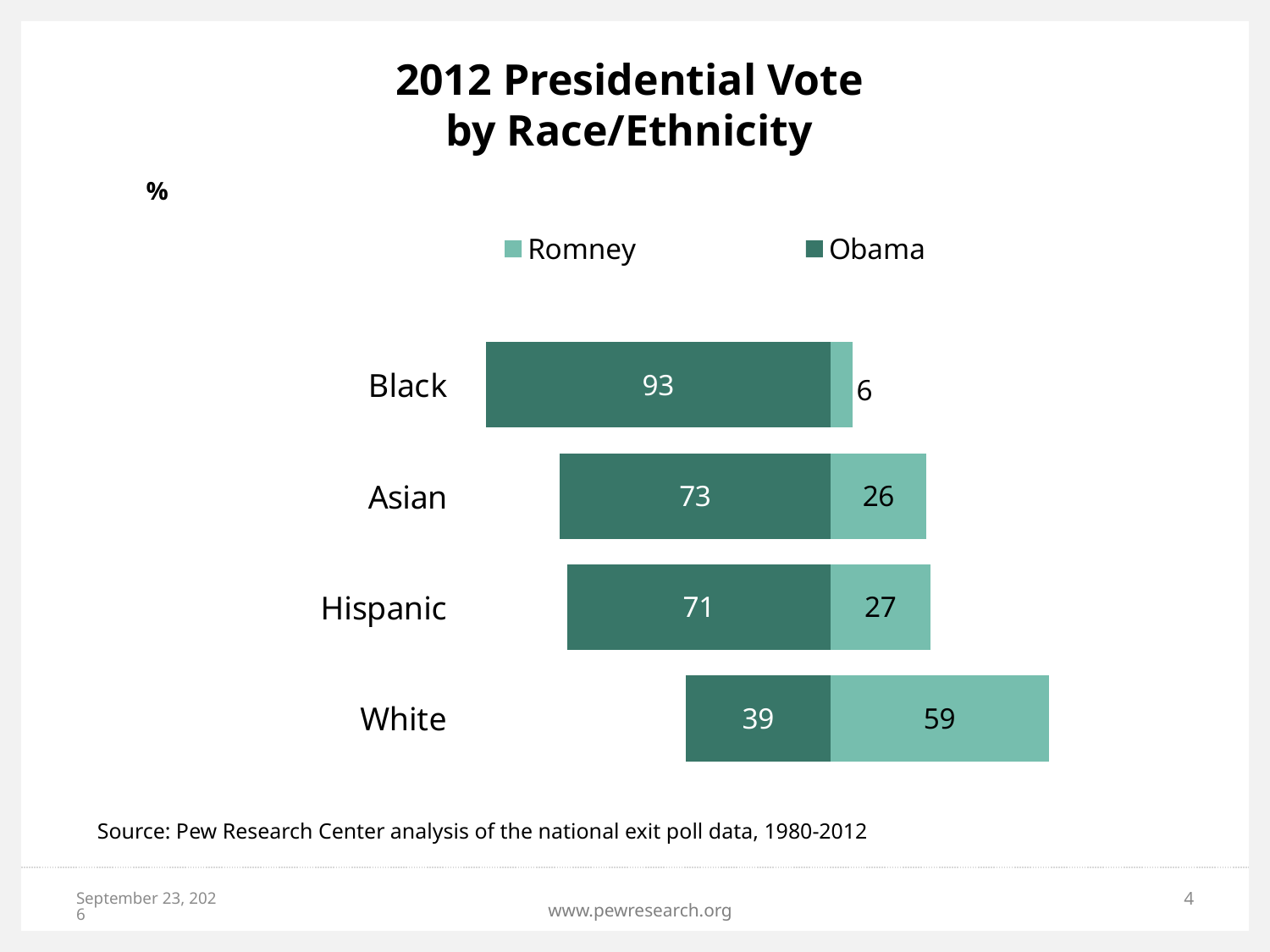
Which racial/ethnic group had the highest share voting for Obama? Black What kind of chart is shown on the slide? Stacked bar chart What is the total of the stacked bar for Asian voters? 99 How many racial/ethnic groups are shown in the chart? 4 Among Hispanic voters, which candidate received the larger share? Obama Which racial/ethnic group had the lowest share voting for Romney? Black What is the difference between the Obama and Romney shares among White voters? 20 What percentage of Asian voters voted for Romney? 26 How many series does the legend list? 2 What percentage of Hispanic voters voted for Obama? 71 What percentage of Black voters voted for Obama? 93 What percentage of White voters voted for Romney? 59